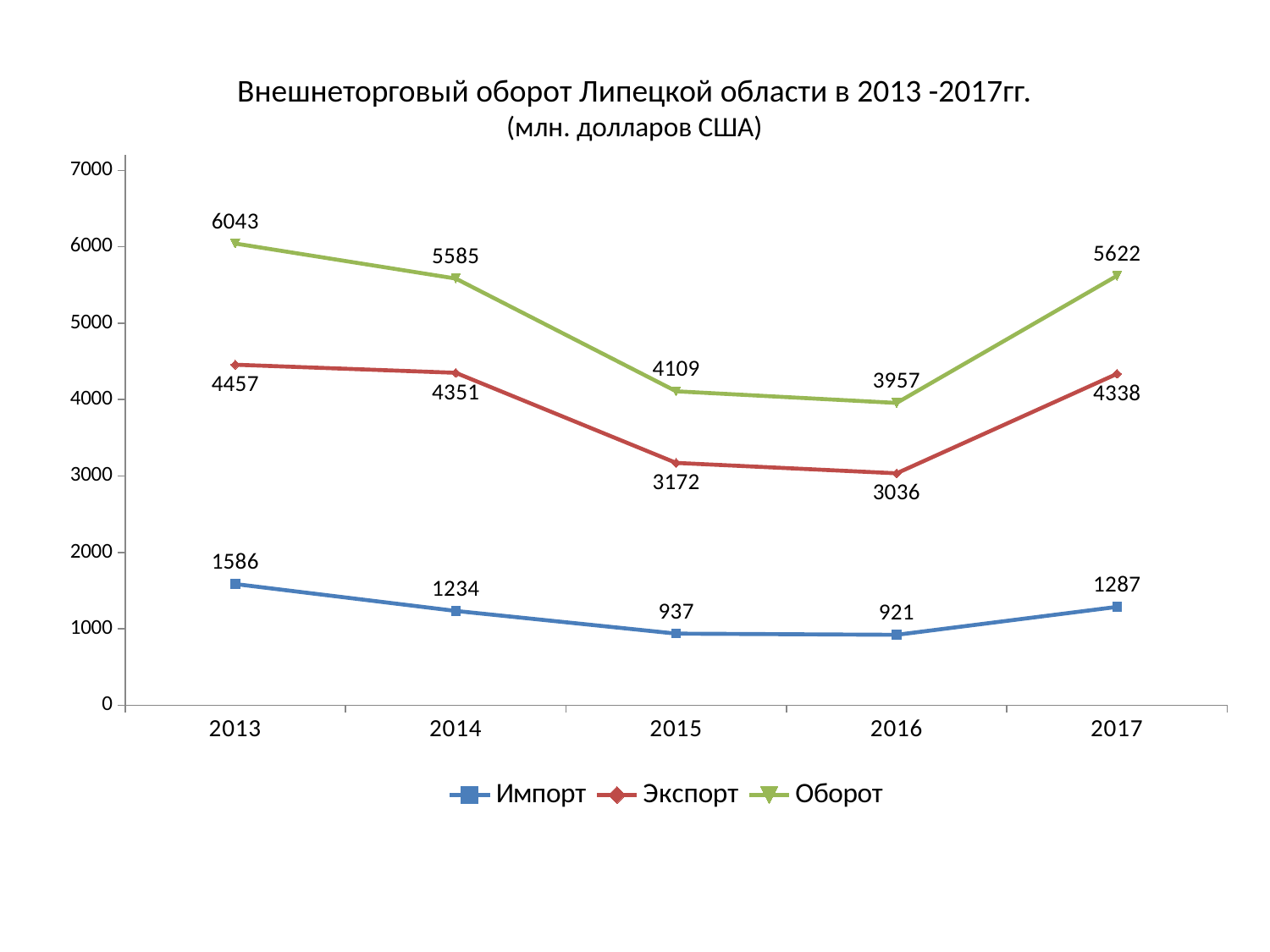
How many series does the legend list? 3 What is the value of Оборот in 2017? 5622 How many years are shown on the x axis? 5 What kind of chart is shown on the slide? line chart In which year is Оборот highest? 2013 What is the difference between Экспорт in 2013 and Экспорт in 2017? 119 What is the value of Импорт in 2013? 1586 In which year is Импорт lowest? 2016 Which is larger: Оборот in 2014 or Оборот in 2017? Оборот in 2017 What is the value of Экспорт in 2016? 3036 Is the value of Экспорт in 2015 greater or less than 3000? greater Does Импорт rise or fall from 2013 to 2016? fall